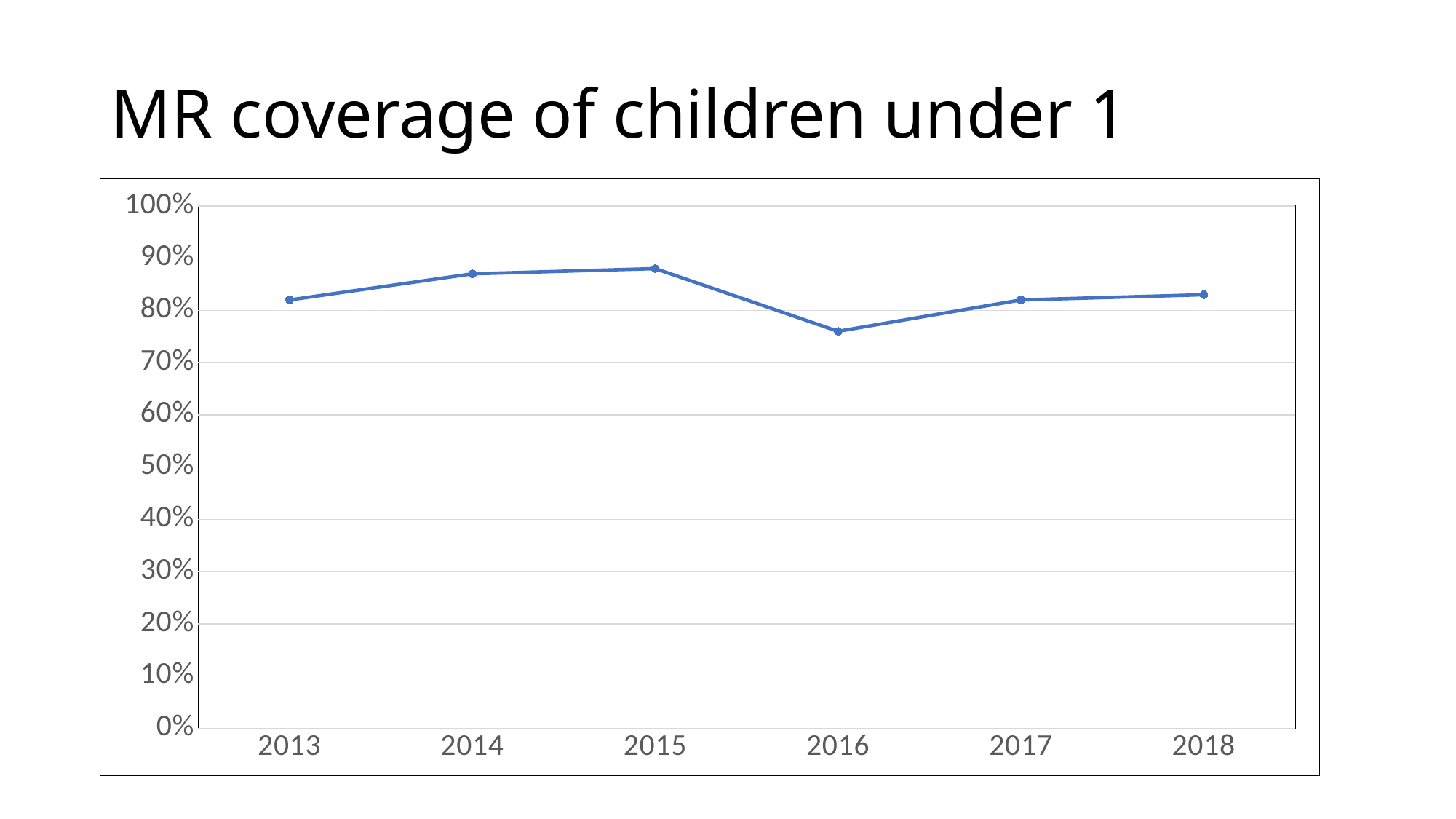
Is the value for 2015 greater or less than 80%? greater Which is larger, the value for 2016 or the value for 2018? 2018 Does the coverage rise or fall from 2015 to 2016? fall What is the title of the chart? MR coverage of children under 1 Does the coverage rise or fall from 2013 to 2015? rise What kind of chart is shown on the slide? line chart Is the value for 2016 greater or less than 80%? less Which is larger, the value for 2015 or the value for 2016? 2015 Is the value for 2016 greater or less than 70%? greater How many years are plotted on the x axis? 6 Which year has the lowest MR coverage? 2016